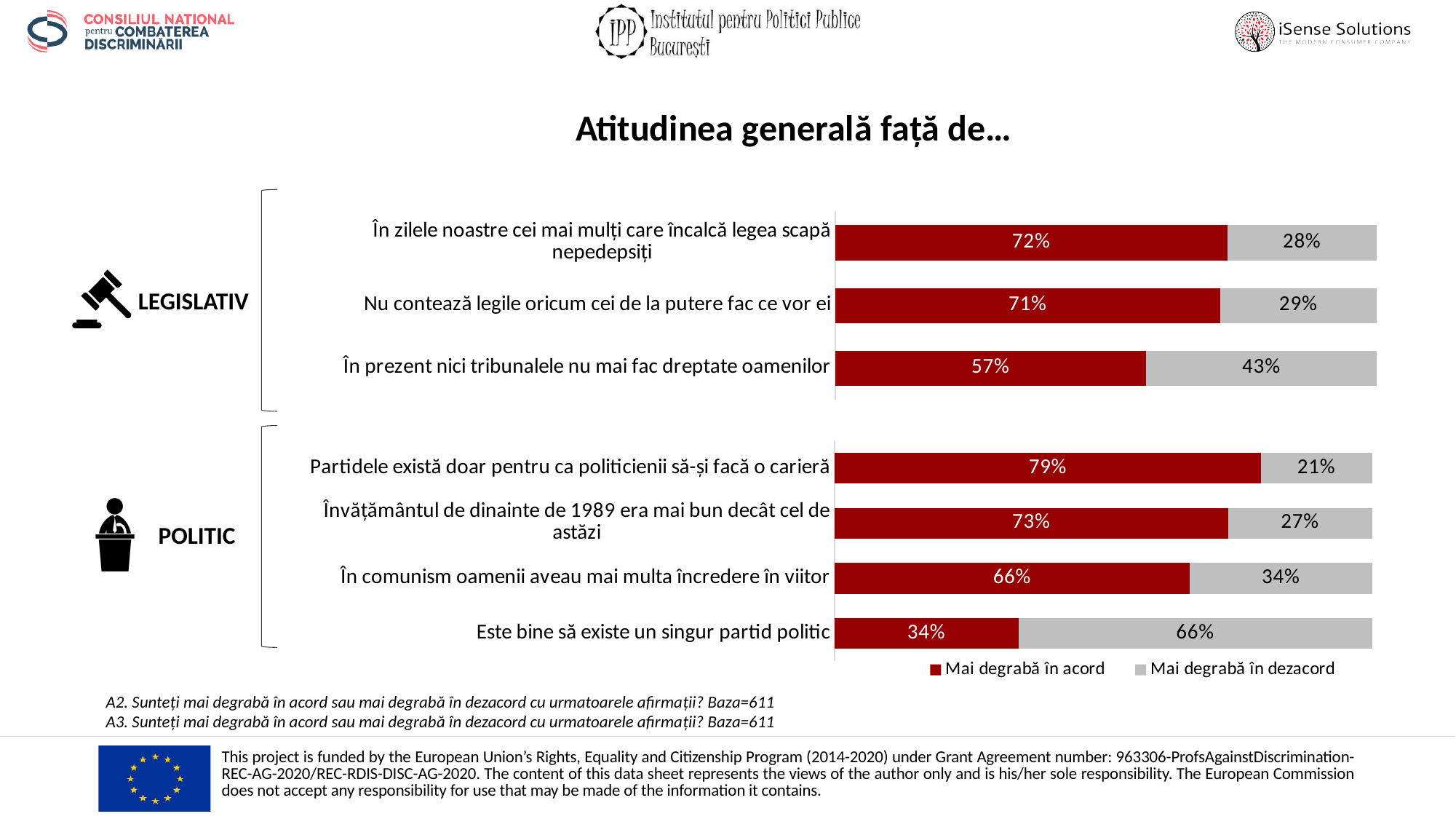
In the POLITIC chart, what percentage is 'Mai degrabă în acord' for 'Este bine să existe un singur partid politic'? 34% In the POLITIC chart, for 'Este bine să existe un singur partid politic', which is larger: 'Mai degrabă în acord' or 'Mai degrabă în dezacord'? Mai degrabă în dezacord In the POLITIC chart, what is the total of the stacked bar for 'În comunism oamenii aveau mai multa încredere în viitor'? 100% In the POLITIC chart, which statement has the highest 'Mai degrabă în acord' percentage? Partidele există doar pentru ca politicienii să-și facă o carieră In the LEGISLATIV chart, what percentage is 'Mai degrabă în acord' for 'În zilele noastre cei mai mulți care încalcă legea scapă nepedepsiți'? 72% How many statements are plotted in the POLITIC chart? 4 In the POLITIC chart, what is the difference between the 'Mai degrabă în acord' percentages for 'Învățământul de dinainte de 1989 era mai bun decât cel de astăzi' and 'În comunism oamenii aveau mai multa încredere în viitor'? 7% How many series does the legend list? 2 How many statements are plotted in the LEGISLATIV chart? 3 What kind of chart is used on this slide? Stacked bar chart In the LEGISLATIV chart, which statement has the lowest 'Mai degrabă în acord' percentage? În prezent nici tribunalele nu mai fac dreptate oamenilor In the LEGISLATIV chart, what percentage is 'Mai degrabă în dezacord' for 'În prezent nici tribunalele nu mai fac dreptate oamenilor'? 43%